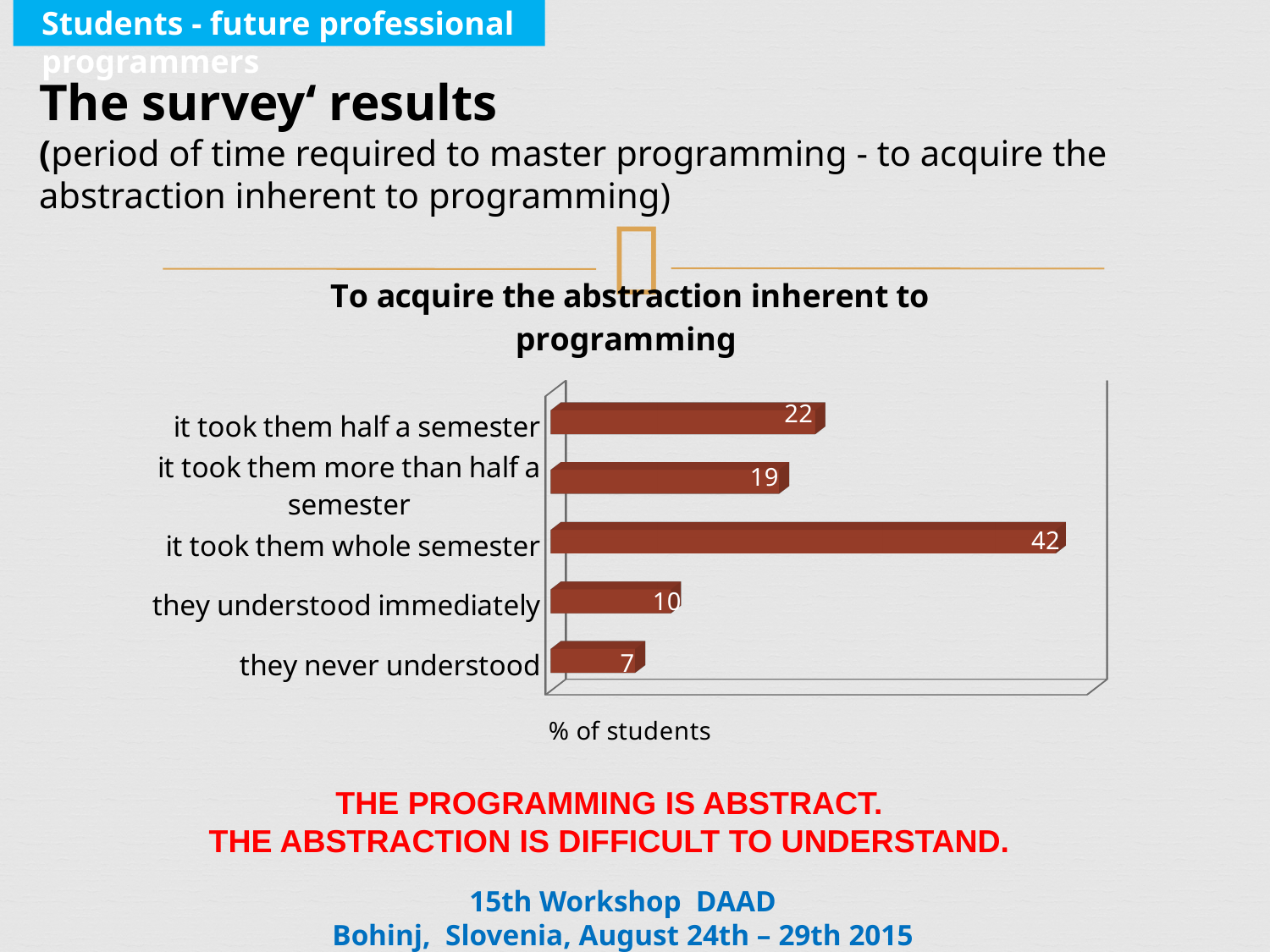
How many categories are shown in the chart? 5 Which category has the highest value? it took them whole semester What is the value for 'they understood immediately'? 10 What kind of chart is shown on the slide? bar chart What is the value for 'they never understood'? 7 What is the difference between the values for 'it took them whole semester' and 'it took them half a semester'? 20 What is the value for 'it took them whole semester'? 42 Which is larger: the value for 'it took them half a semester' or 'it took them more than half a semester'? it took them half a semester What is the value for 'it took them more than half a semester'? 19 What is the title of the chart? To acquire the abstraction inherent to programming Which category has the lowest value? they never understood What is the label shown below the chart's horizontal axis? % of students